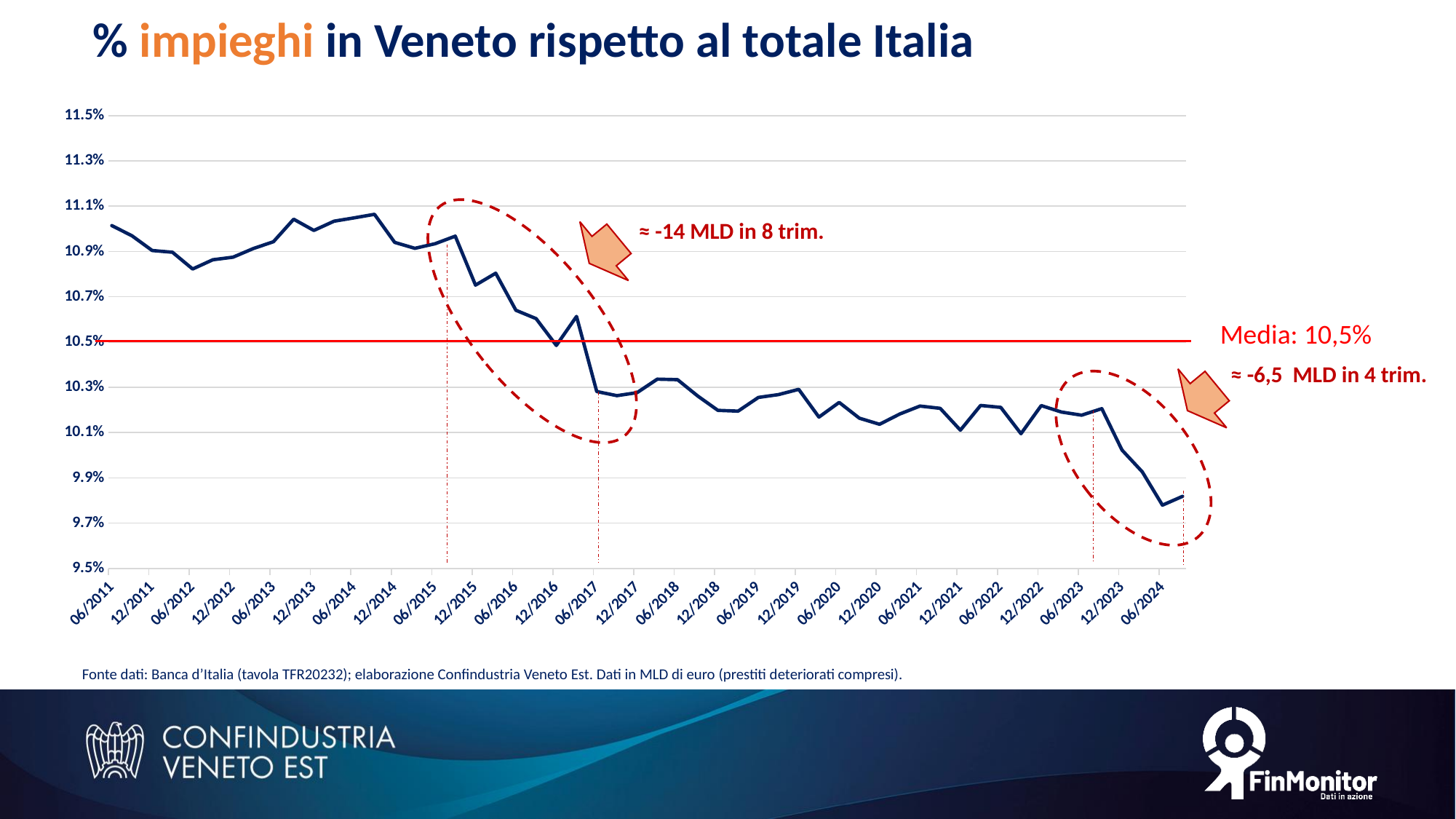
Overall, do the values rise or fall from 06/2011 to 06/2024? fall Is the value for 12/2023 greater or less than 10.3%? less Is the value for 06/2017 greater or less than 10.5%? less Which is larger, the value for 06/2011 or the value for 06/2024? 06/2011 Is the value for 12/2019 greater or less than 10.5%? less Which is larger, the value for 06/2015 or the value for 06/2017? 06/2015 What is the title of the chart? % impieghi in Veneto rispetto al totale Italia What kind of chart is shown on the slide? line chart What value does the horizontal red 'Media' line mark? 10,5%